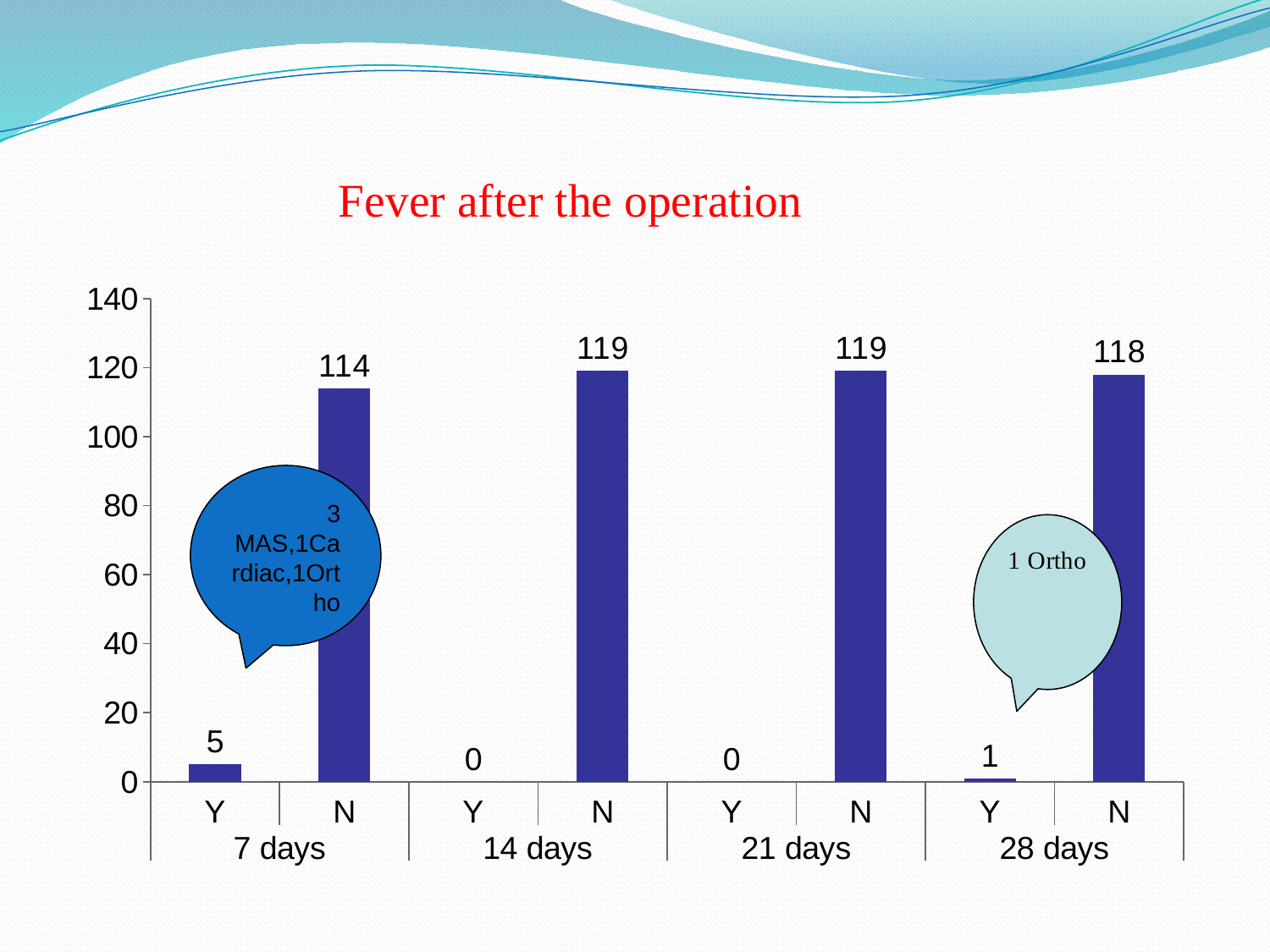
What is the value for N at 28 days? 118 What is the title of the chart? Fever after the operation Which is larger, the N value at 21 days or the N value at 28 days? 21 days What is the difference between the N value at 14 days and the N value at 7 days? 5 Which time point has the highest Y value? 7 days What is the value for Y at 7 days? 5 How many bars are plotted in the chart? 8 What is the value for Y at 28 days? 1 Which time point has the lowest N value? 7 days What is the value for N at 7 days? 114 What is the value for N at 14 days? 119 What kind of chart is shown on the slide? bar chart